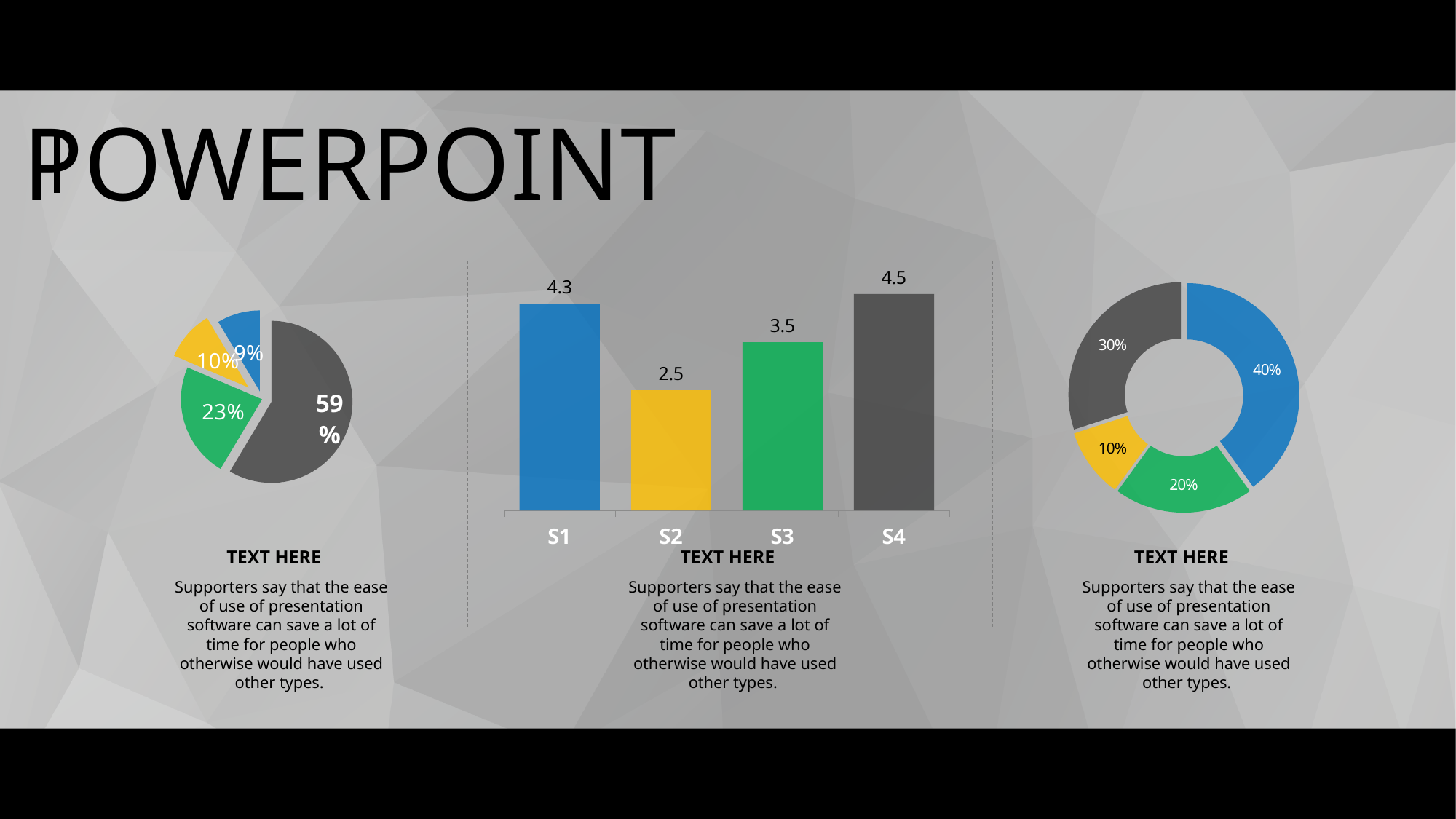
On the pie chart on the left of the slide, what share does the largest (dark grey) slice have? 59% On the bar chart in the middle of the slide, what is the value for S2? 2.5 On the pie chart on the left of the slide, what share does the green slice have? 23% On the doughnut chart on the right of the slide, what is the difference between the dark grey segment's share and the yellow segment's share? 20% On the bar chart in the middle of the slide, which category has the lowest value? S2 What kind of chart is shown in the middle of the slide? bar chart On the bar chart in the middle of the slide, which category has the highest value? S4 How many categories are shown on the bar chart in the middle of the slide? 4 On the bar chart in the middle of the slide, what is the difference between the values for S4 and S3? 1 On the bar chart in the middle of the slide, which is larger, the value for S1 or the value for S3? S1 On the doughnut chart on the right of the slide, what share does the blue segment have? 40% On the bar chart in the middle of the slide, what is the value for S1? 4.3